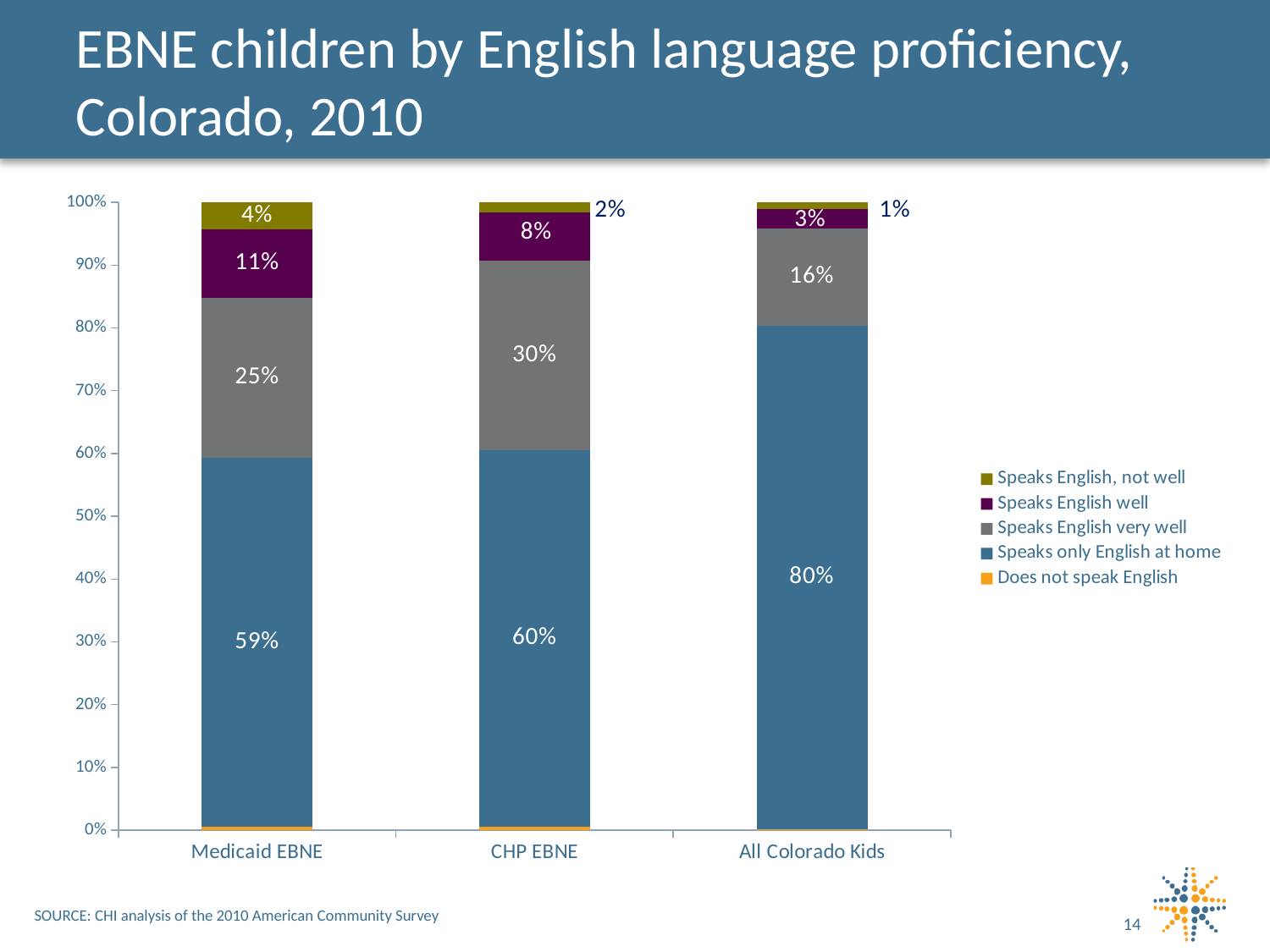
Which legend entry is shown in orange? Does not speak English Which category has the highest share of children who speak only English at home? All Colorado Kids What percentage of CHP EBNE children speak English well? 8% What kind of chart is shown on the slide? Stacked bar chart How many series does the legend list? 5 What is the difference between the share of All Colorado Kids and Medicaid EBNE children who speak only English at home? 21% What percentage of Medicaid EBNE children speak only English at home? 59% Which category has the lowest share of children who speak English very well? All Colorado Kids What percentage of All Colorado Kids speak English very well? 16% What percentage of Medicaid EBNE children speak English, not well? 4% How many categories are shown on the x axis? 3 Which is larger: the share of CHP EBNE children who speak English very well or the share of Medicaid EBNE children who speak English very well? CHP EBNE